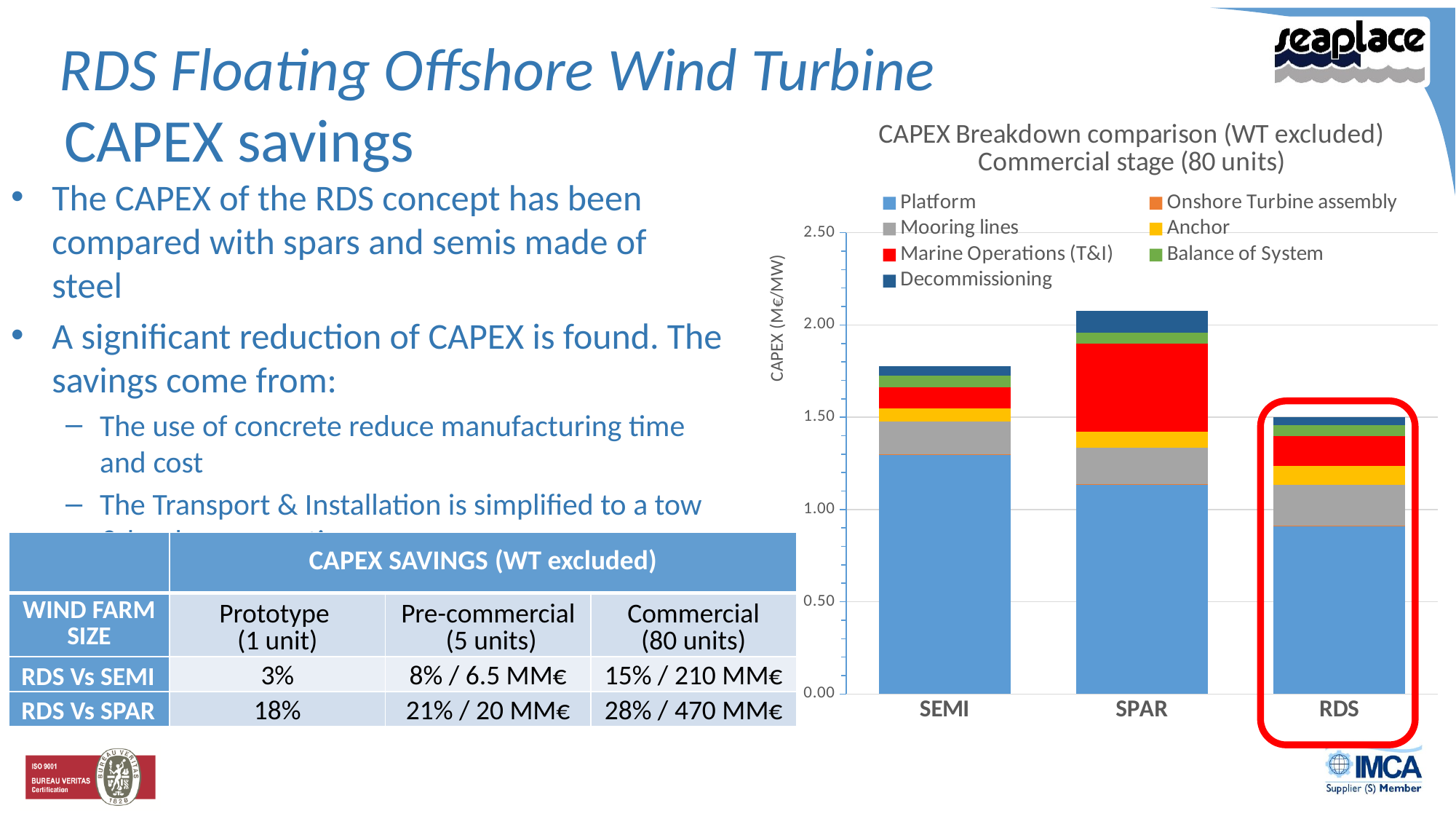
Which category has the highest total CAPEX in the chart? SPAR Is the total CAPEX for SEMI greater or less than 2.00? less Is the total CAPEX for SPAR greater or less than 2.00? greater Which category has the lowest total CAPEX in the chart? RDS What is the label of the chart's y axis? CAPEX (M€/MW) Which has a larger total CAPEX, SEMI or SPAR? SPAR How many series does the chart legend list? 7 How many categories are shown on the x axis of the chart? 3 What is the title of the chart? CAPEX Breakdown comparison (WT excluded) Commercial stage (80 units) What kind of chart is shown on the slide? Stacked bar chart Is the Platform value for SEMI greater or less than 1.00? greater